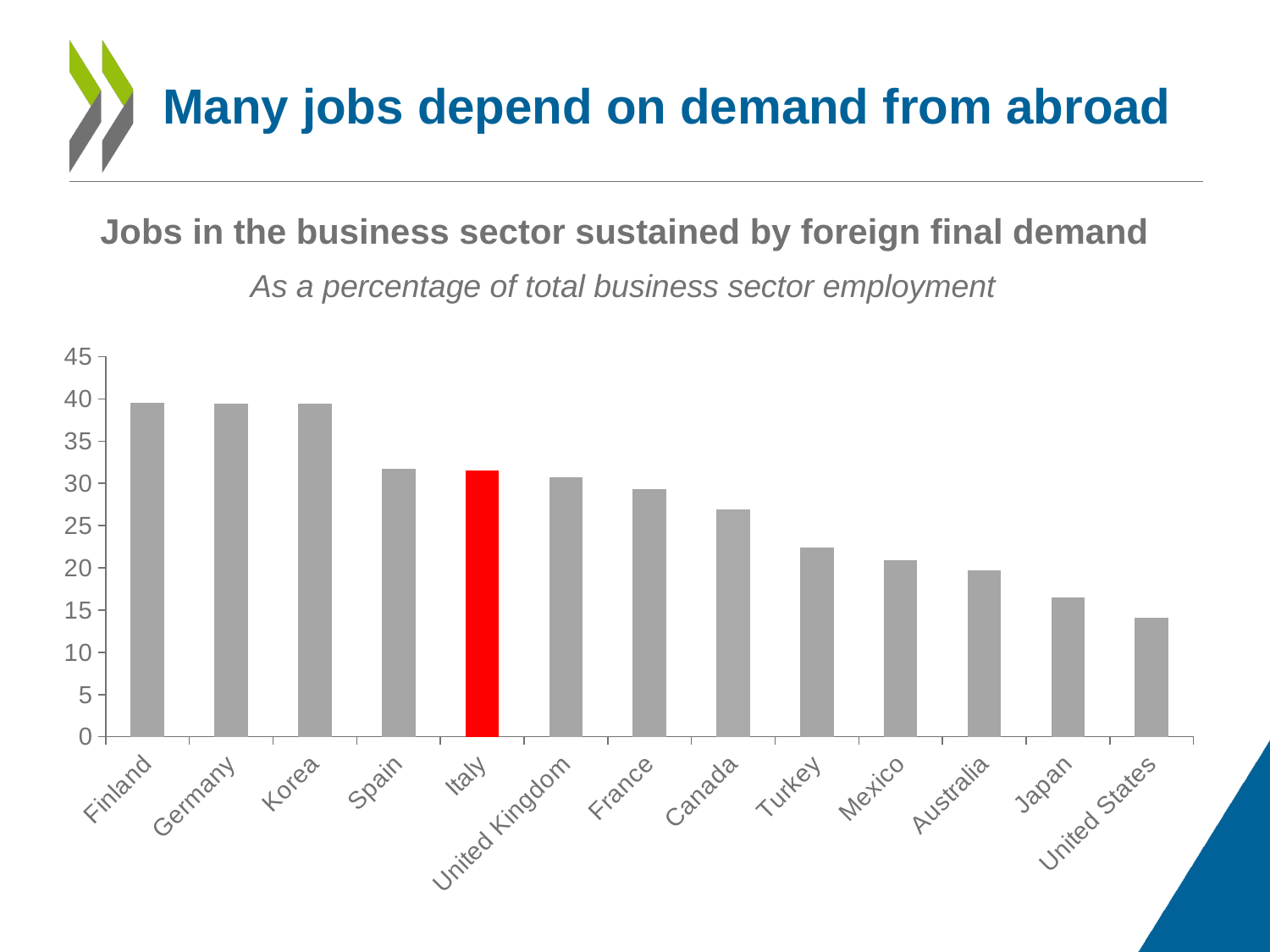
Is the value for Turkey greater or less than 20? greater Is the value for Canada greater or less than 25? greater Is the value for Italy greater or less than 30? greater Which has a higher value, Japan or the United States? Japan Which has a higher value, Italy or France? Italy How many countries are shown on the chart? 13 What kind of chart is shown on the slide? bar chart Do the values rise or fall moving from left to right across the countries? fall Which country's bar is highlighted in red? Italy Which country has the lowest share of business sector jobs sustained by foreign final demand? United States